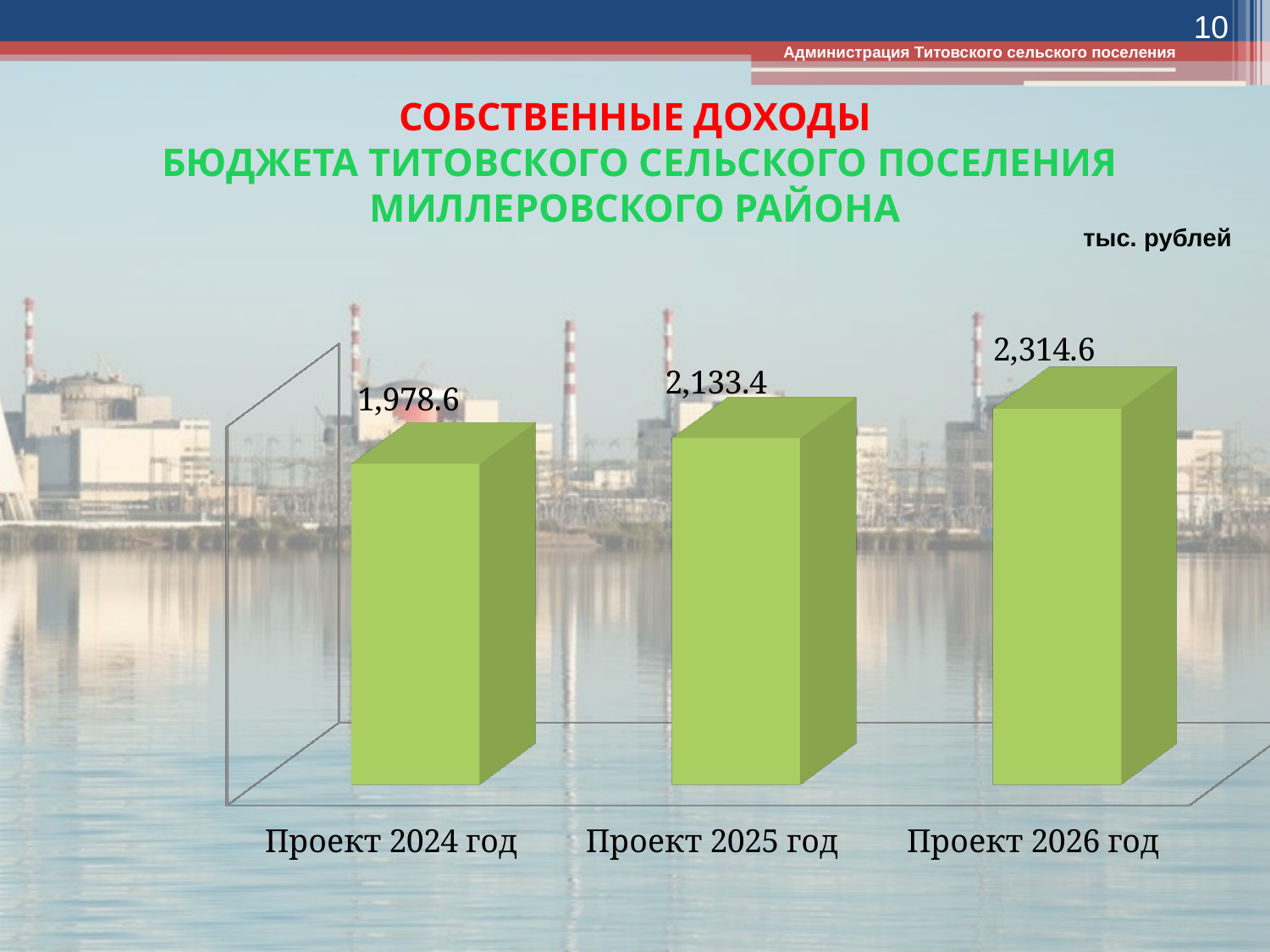
What kind of chart is shown on the slide? Bar chart In what units are the chart values given? тыс. рублей Do the values rise or fall from Проект 2024 год to Проект 2026 год? Rise Which is larger, the value for Проект 2024 год or Проект 2026 год? Проект 2026 год What is the difference between the values for Проект 2026 год and Проект 2025 год? 181.2 What is the difference between the values for Проект 2025 год and Проект 2024 год? 154.8 What is the value for Проект 2026 год? 2,314.6 Which category has the lowest value? Проект 2024 год Which category has the highest value? Проект 2026 год What is the value for Проект 2025 год? 2,133.4 What is the value for Проект 2024 год? 1,978.6 How many categories are shown in the chart? 3